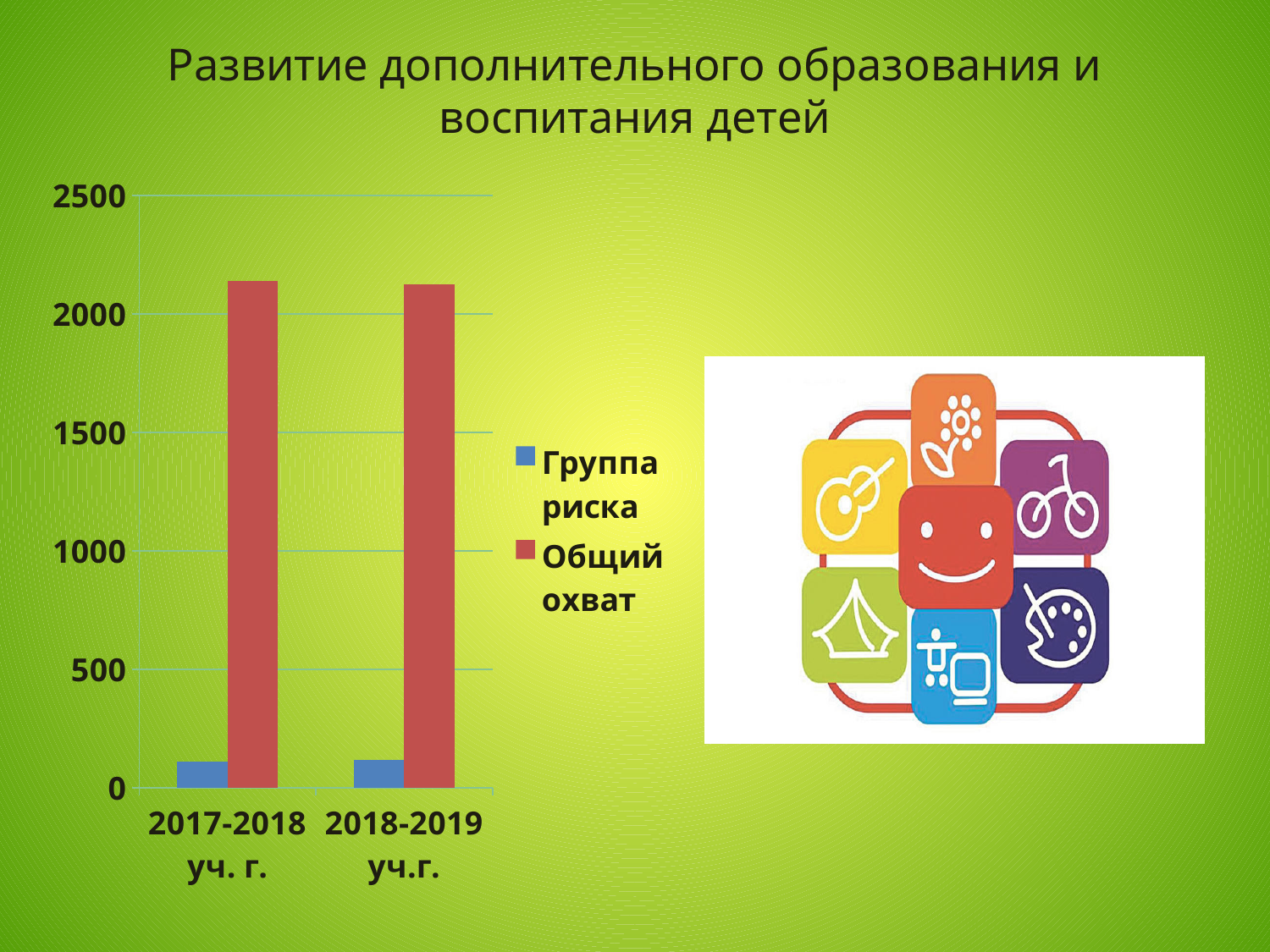
In 2018-2019 уч.г., which series has the smaller value, Группа риска or Общий охват? Группа риска Is the value for Общий охват in 2017-2018 уч. г. greater or less than 2000? greater How many categories are shown on the x axis of the chart? 2 In 2017-2018 уч. г., which series has the larger value, Группа риска or Общий охват? Общий охват Is the value for Общий охват in 2018-2019 уч.г. greater or less than 2000? greater How many series does the chart legend list? 2 Is the value for Группа риска in 2017-2018 уч. г. greater or less than 500? less Which series is shown in red in the chart? Общий охват Which series is shown in blue in the chart? Группа риска What kind of chart is shown on the slide? bar chart